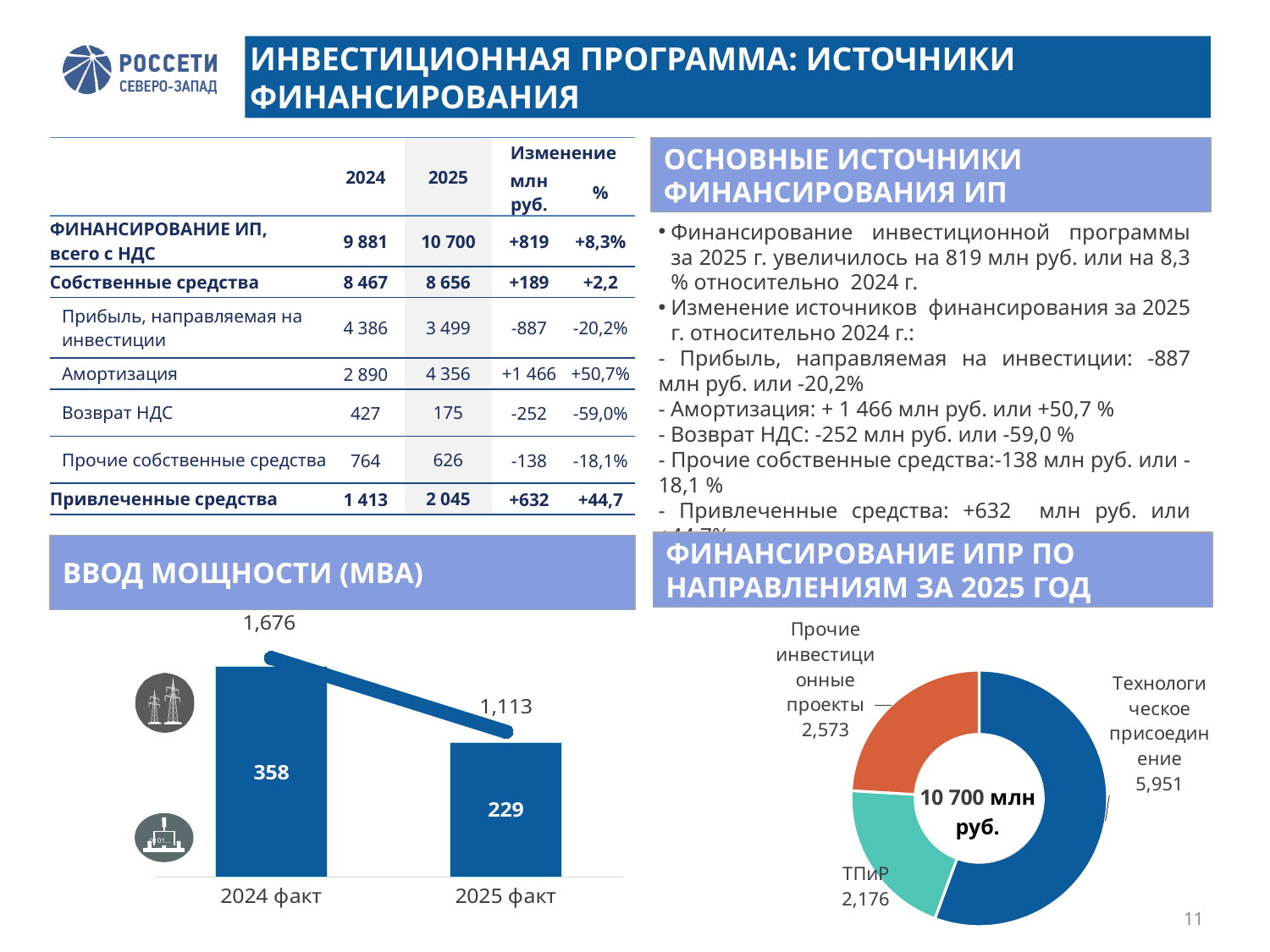
In the donut chart 'ФИНАНСИРОВАНИЕ ИПР ПО НАПРАВЛЕНИЯМ ЗА 2025 ГОД', what is the value for ТПиР? 2,176 In the chart 'ВВОД МОЩНОСТИ (МВА)', do the bar values rise or fall from 2024 факт to 2025 факт? fall In the chart 'ВВОД МОЩНОСТИ (МВА)', what is the value printed on the bar for 2025 факт? 229 In the donut chart 'ФИНАНСИРОВАНИЕ ИПР ПО НАПРАВЛЕНИЯМ ЗА 2025 ГОД', how many categories are shown? 3 In the donut chart 'ФИНАНСИРОВАНИЕ ИПР ПО НАПРАВЛЕНИЯМ ЗА 2025 ГОД', which category has the largest value? Технологическое присоединение In the chart 'ВВОД МОЩНОСТИ (МВА)', what is the value of the line point for 2024 факт? 1,676 In the chart 'ВВОД МОЩНОСТИ (МВА)', what is the difference between the bar values for 2024 факт and 2025 факт? 129 In the donut chart 'ФИНАНСИРОВАНИЕ ИПР ПО НАПРАВЛЕНИЯМ ЗА 2025 ГОД', which category has the smallest value? ТПиР What total is printed in the centre of the donut chart 'ФИНАНСИРОВАНИЕ ИПР ПО НАПРАВЛЕНИЯМ ЗА 2025 ГОД'? 10 700 млн руб. In the donut chart 'ФИНАНСИРОВАНИЕ ИПР ПО НАПРАВЛЕНИЯМ ЗА 2025 ГОД', what is the value for Технологическое присоединение? 5,951 In the chart 'ВВОД МОЩНОСТИ (МВА)', what is the value printed on the bar for 2024 факт? 358 In the donut chart 'ФИНАНСИРОВАНИЕ ИПР ПО НАПРАВЛЕНИЯМ ЗА 2025 ГОД', what is the difference between Прочие инвестиционные проекты and ТПиР? 397